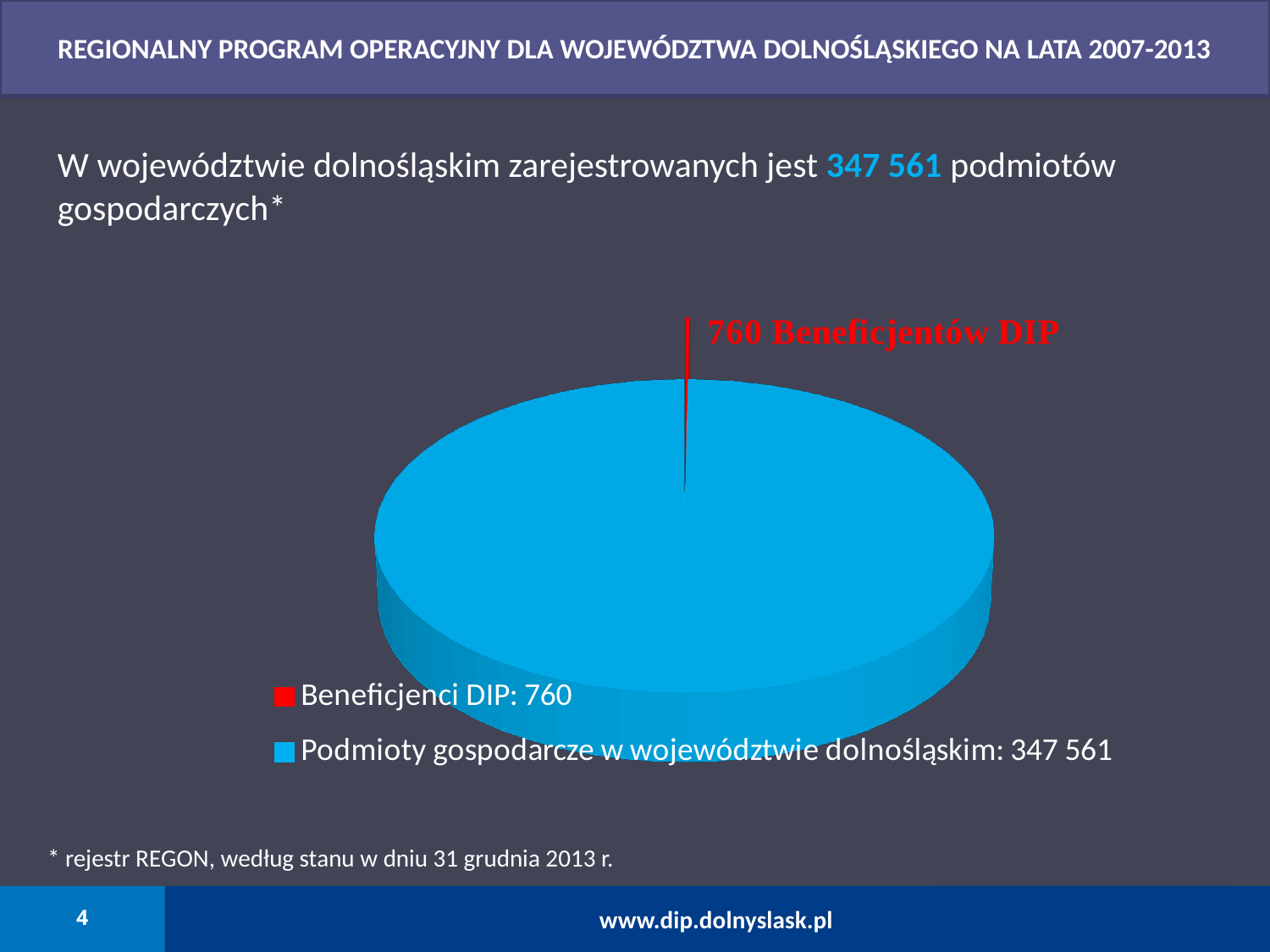
What type of chart is shown on the slide? pie chart Which slice of the pie chart is the largest? Podmioty gospodarcze w województwie dolnośląskim Which slice of the pie chart is the smallest? Beneficjenci DIP How many entries does the chart legend list? 2 Which is larger: Beneficjenci DIP or Podmioty gospodarcze w województwie dolnośląskim? Podmioty gospodarcze w województwie dolnośląskim What is the difference between the value for Podmioty gospodarcze w województwie dolnośląskim and the value for Beneficjenci DIP? 346 801 What is the value for Beneficjenci DIP in the pie chart? 760 What colour is the Beneficjenci DIP slice in the pie chart? red What is the value for Podmioty gospodarcze w województwie dolnośląskim in the pie chart? 347 561 How many slices does the pie chart have? 2 What label is written in red above the pie chart? 760 Beneficjentów DIP